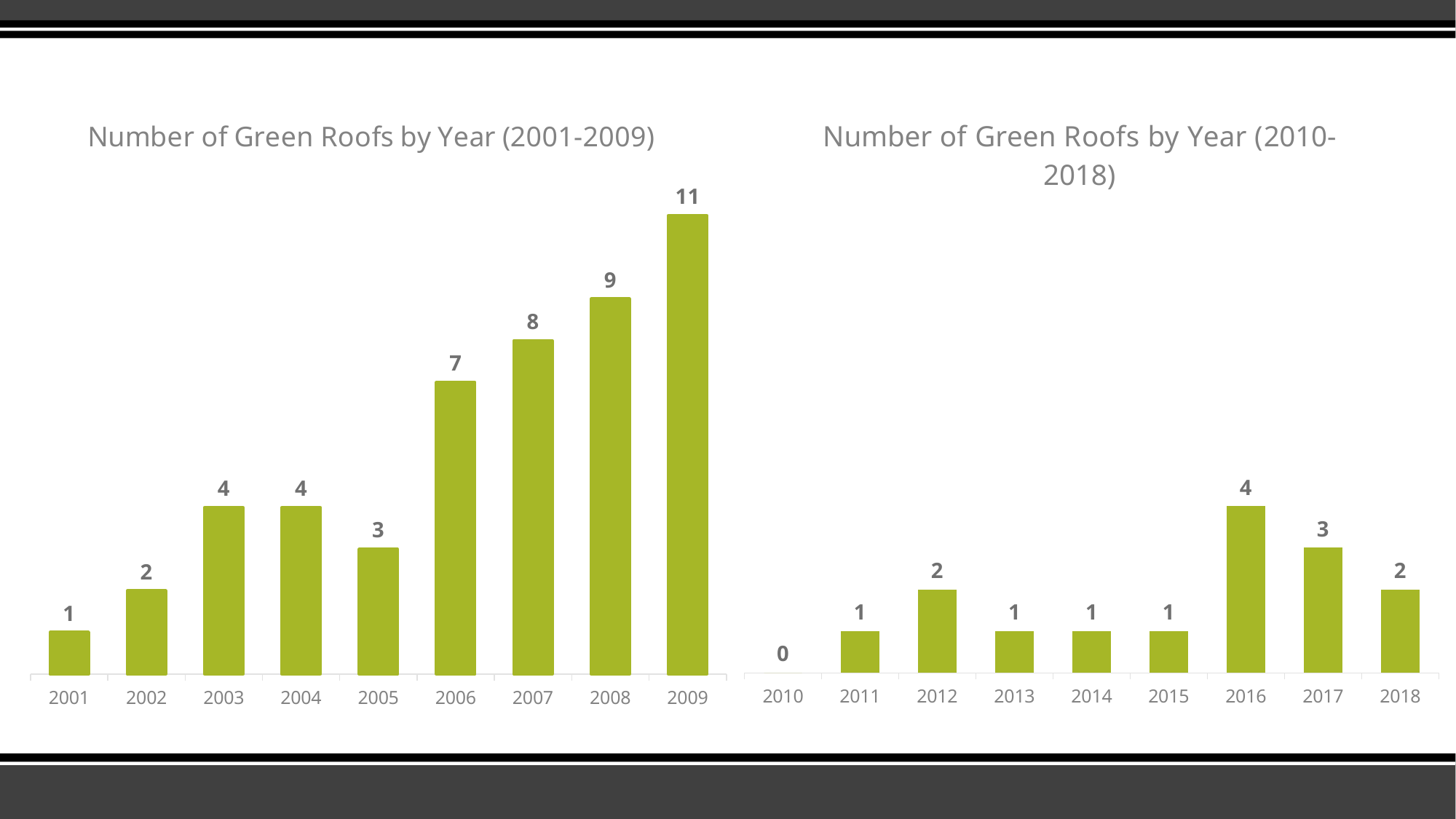
How many years are shown in the 'Number of Green Roofs by Year (2010-2018)' chart? 9 What kind of chart is the 'Number of Green Roofs by Year (2001-2009)' chart? Bar chart In the 'Number of Green Roofs by Year (2010-2018)' chart, what is the difference between the values for 2017 and 2012? 1 In the 'Number of Green Roofs by Year (2010-2018)' chart, what is the value for 2016? 4 In the 'Number of Green Roofs by Year (2001-2009)' chart, do the values generally rise or fall from 2005 to 2009? Rise In the 'Number of Green Roofs by Year (2001-2009)' chart, which year has the lowest value? 2001 In the 'Number of Green Roofs by Year (2001-2009)' chart, what is the value for 2006? 7 In the 'Number of Green Roofs by Year (2010-2018)' chart, which year has the highest value? 2016 In the 'Number of Green Roofs by Year (2001-2009)' chart, which year has the highest value? 2009 In the 'Number of Green Roofs by Year (2001-2009)' chart, what is the difference between the values for 2009 and 2005? 8 In the 'Number of Green Roofs by Year (2001-2009)' chart, which is larger, the value for 2008 or the value for 2007? 2008 In the 'Number of Green Roofs by Year (2010-2018)' chart, which year has the lowest value? 2010